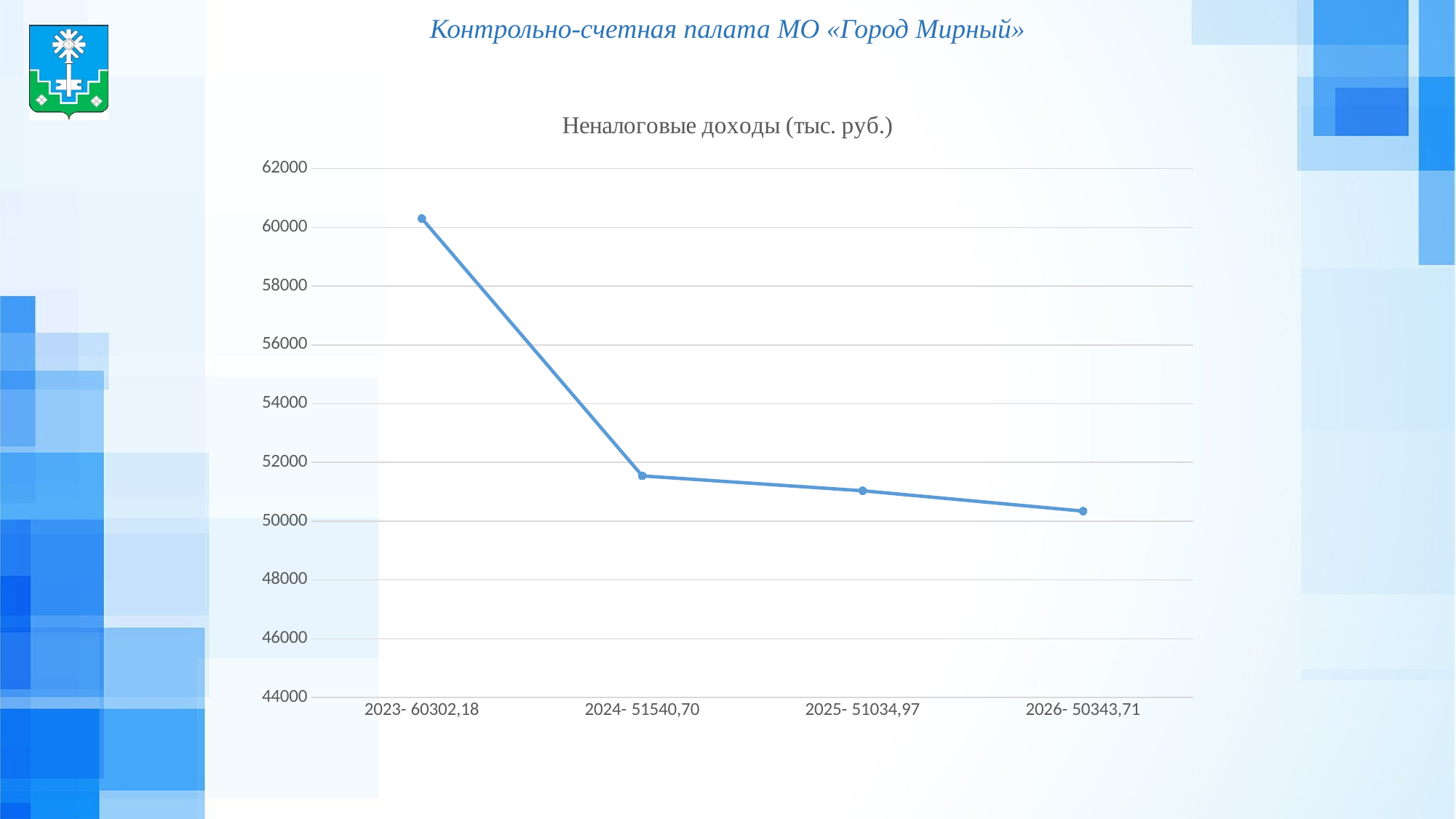
What is the value of non-tax revenue for 2024? 51540,70 Which is larger, the value for 2024 or the value for 2025? 2024 What is the value of non-tax revenue for 2023? 60302,18 Which year has the lowest non-tax revenue? 2026 What is the difference between the 2025 and 2026 values? 691,26 What is the difference between the 2023 and 2024 values? 8761,48 How many data points are plotted on the chart? 4 Which year has the highest non-tax revenue? 2023 Is the value for 2025 greater or less than 52000? less What is the title of the chart? Неналоговые доходы (тыс. руб.) What type of chart is shown on the slide? line chart What is the value of non-tax revenue for 2026? 50343,71